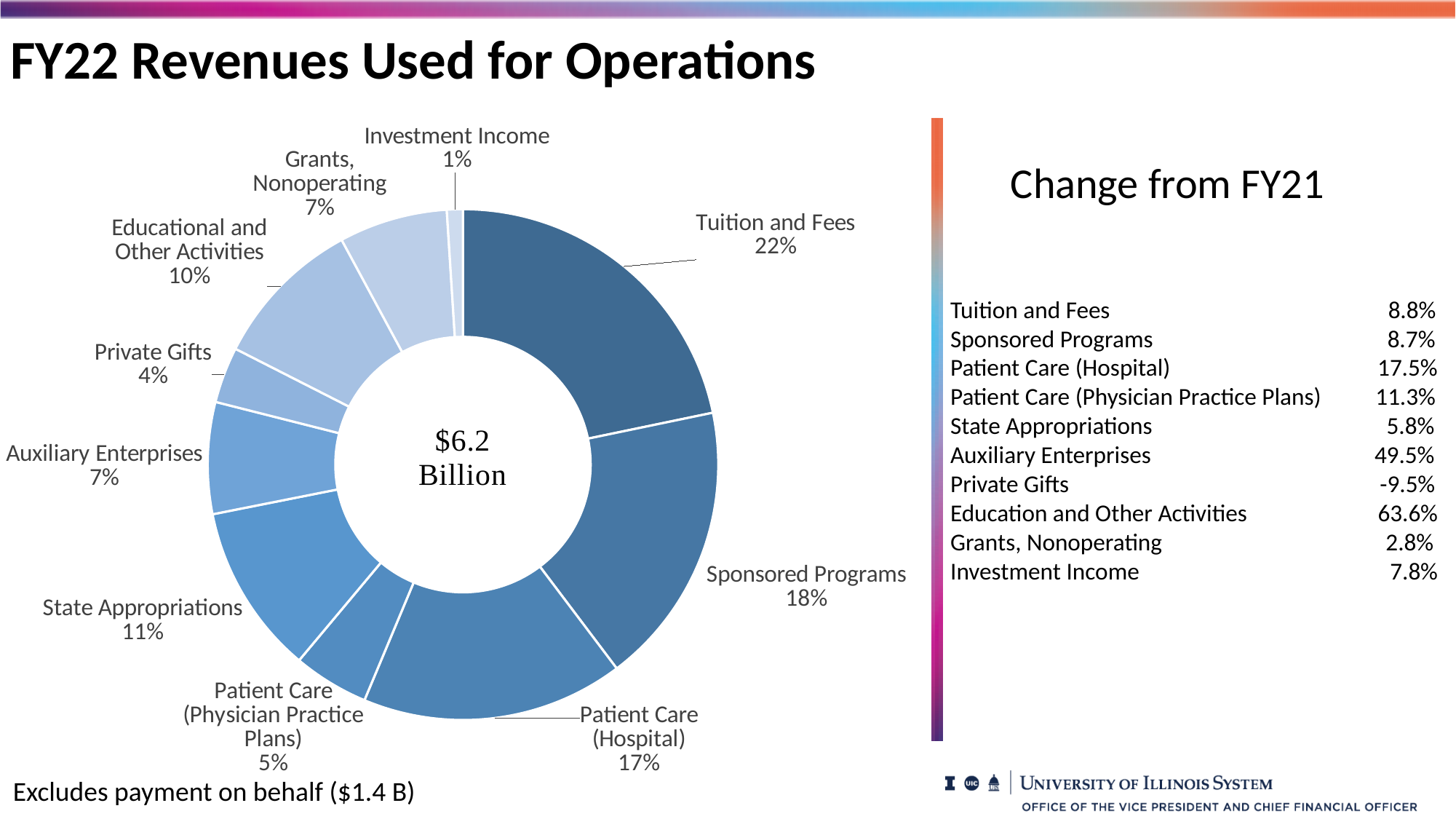
What total amount is printed in the center of the chart? $6.2 Billion What share of FY22 revenues used for operations comes from Tuition and Fees? 22% Which category has the smallest slice of the pie? Investment Income What is the combined share of Grants, Nonoperating and Investment Income? 8% What percentage of the pie is Patient Care (Physician Practice Plans)? 5% What is the difference in percentage points between Sponsored Programs and Private Gifts? 14 Which is larger, the share for Educational and Other Activities or the share for Auxiliary Enterprises? Educational and Other Activities What kind of chart is used to show the FY22 revenues? Pie chart Which category has the largest slice of the pie? Tuition and Fees What percentage of the pie is Patient Care (Hospital)? 17% What percentage does State Appropriations represent in the chart? 11% How many categories are shown in the pie chart? 10